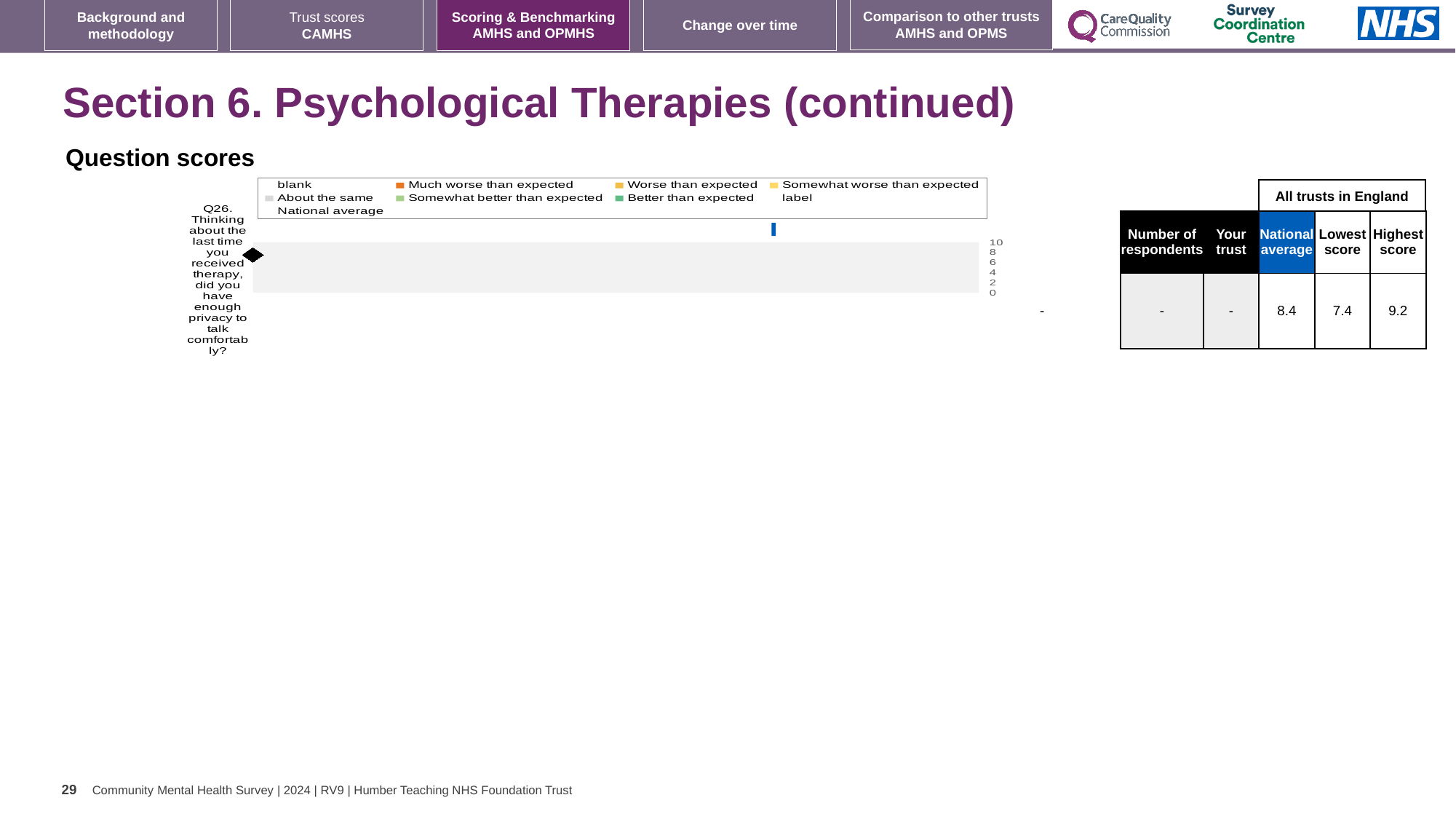
What kind of chart is shown under 'Question scores'? bar chart In the table next to the chart, what value is shown for 'Your trust' for Q26? - What is the highest tick value shown on the chart's value axis? 10 In the table next to the chart, what is the National average score for Q26? 8.4 In the table next to the chart, what is the difference between the Highest score and the Lowest score for Q26? 1.8 In the table next to the chart, what is the Lowest score among all trusts in England for Q26? 7.4 In the table next to the chart, what is the Highest score among all trusts in England for Q26? 9.2 How many questions (categories) are plotted on the chart? 1 How many entries does the chart legend list? 9 In the table next to the chart, which is larger for Q26: the National average or the Lowest score? National average Which question number is plotted on the chart? Q26